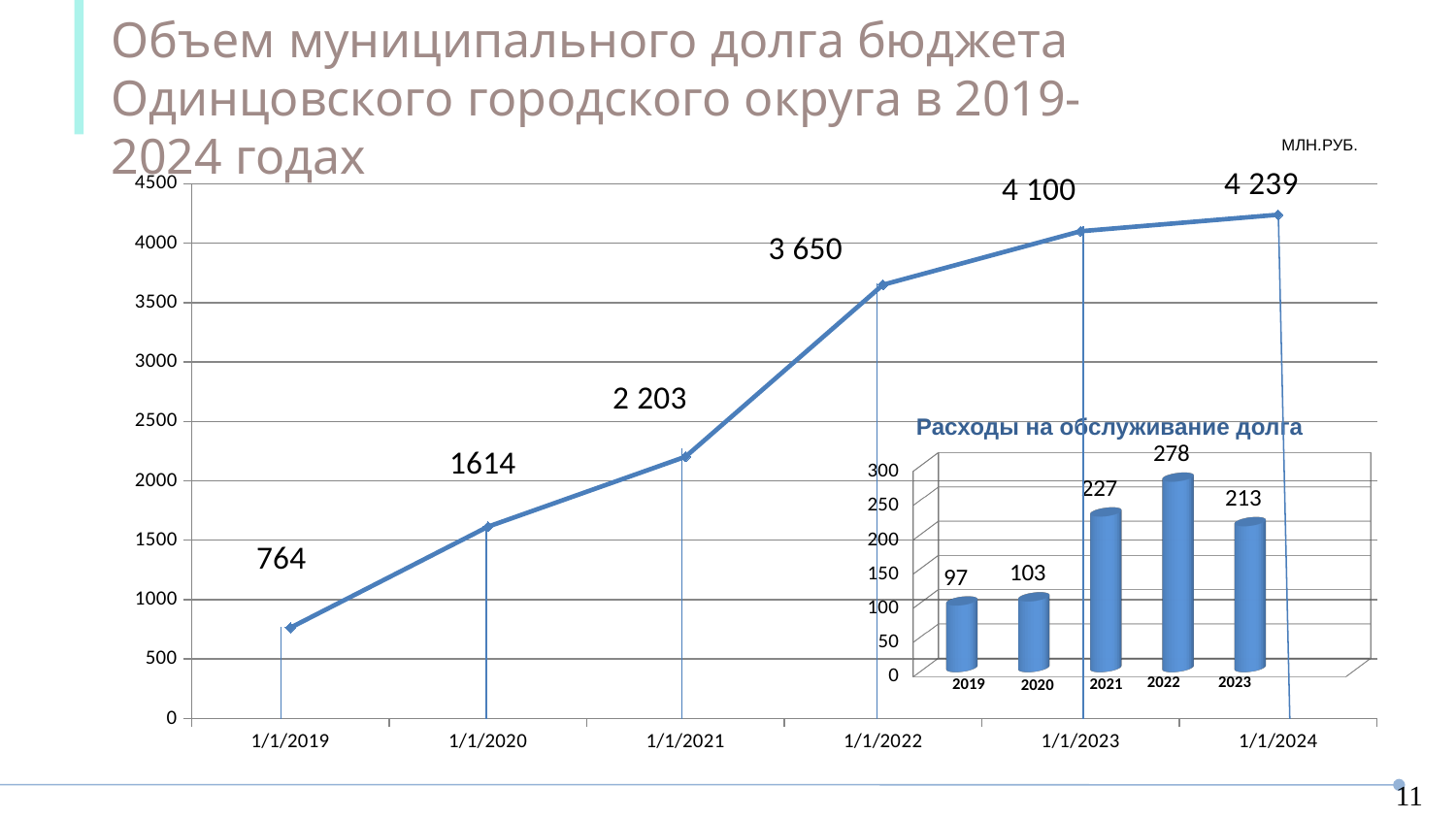
On the line chart, what is the difference between the values for 1/1/2024 and 1/1/2023? 139 What kind of chart is the chart titled 'Расходы на обслуживание долга'? bar chart On the chart titled 'Расходы на обслуживание долга', what is the difference between the values for 2021 and 2020? 124 On the line chart, which date has the highest value? 1/1/2024 What unit is indicated in the top right corner of the slide for the line chart? МЛН.РУБ. On the line chart, what is the value for 1/1/2021? 2 203 On the line chart, what is the value for 1/1/2019? 764 On the chart titled 'Расходы на обслуживание долга', which is larger, the value for 2021 or the value for 2023? 2021 On the chart titled 'Расходы на обслуживание долга', what is the value for 2022? 278 On the line chart, do the values rise or fall from 1/1/2019 to 1/1/2024? rise On the line chart, how many data points are plotted? 6 On the chart titled 'Расходы на обслуживание долга', which year has the lowest value? 2019